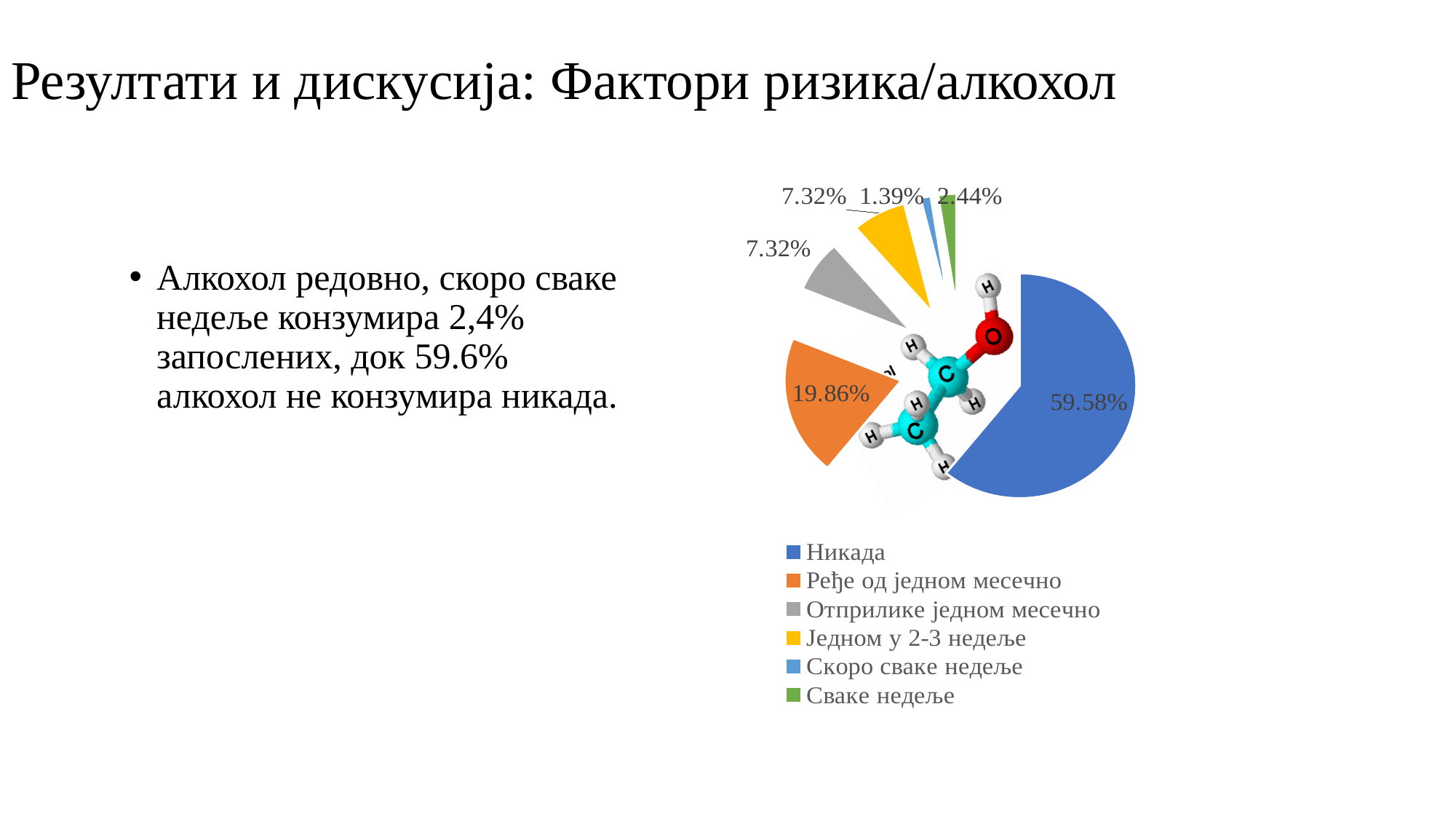
How many categories does the legend of the pie chart list? 6 Which category has the smallest slice of the pie? Скоро сваке недеље What kind of chart is shown on the slide? pie chart What colour is the slice for "Отприлике једном месечно"? gray What is the value shown for "Ређе од једном месечно"? 19.86% What is the value shown for "Сваке недеље"? 2.44% What share of the pie does the "Никада" slice represent? 59.58% What is the value shown for "Једном у 2-3 недеље"? 7.32% Which category has the largest slice of the pie? Никада Which is larger, the value for "Сваке недеље" or the value for "Скоро сваке недеље"? Сваке недеље What is the difference between the values for "Никада" and "Ређе од једном месечно"? 39.72% What is the value shown for "Скоро сваке недеље"? 1.39%